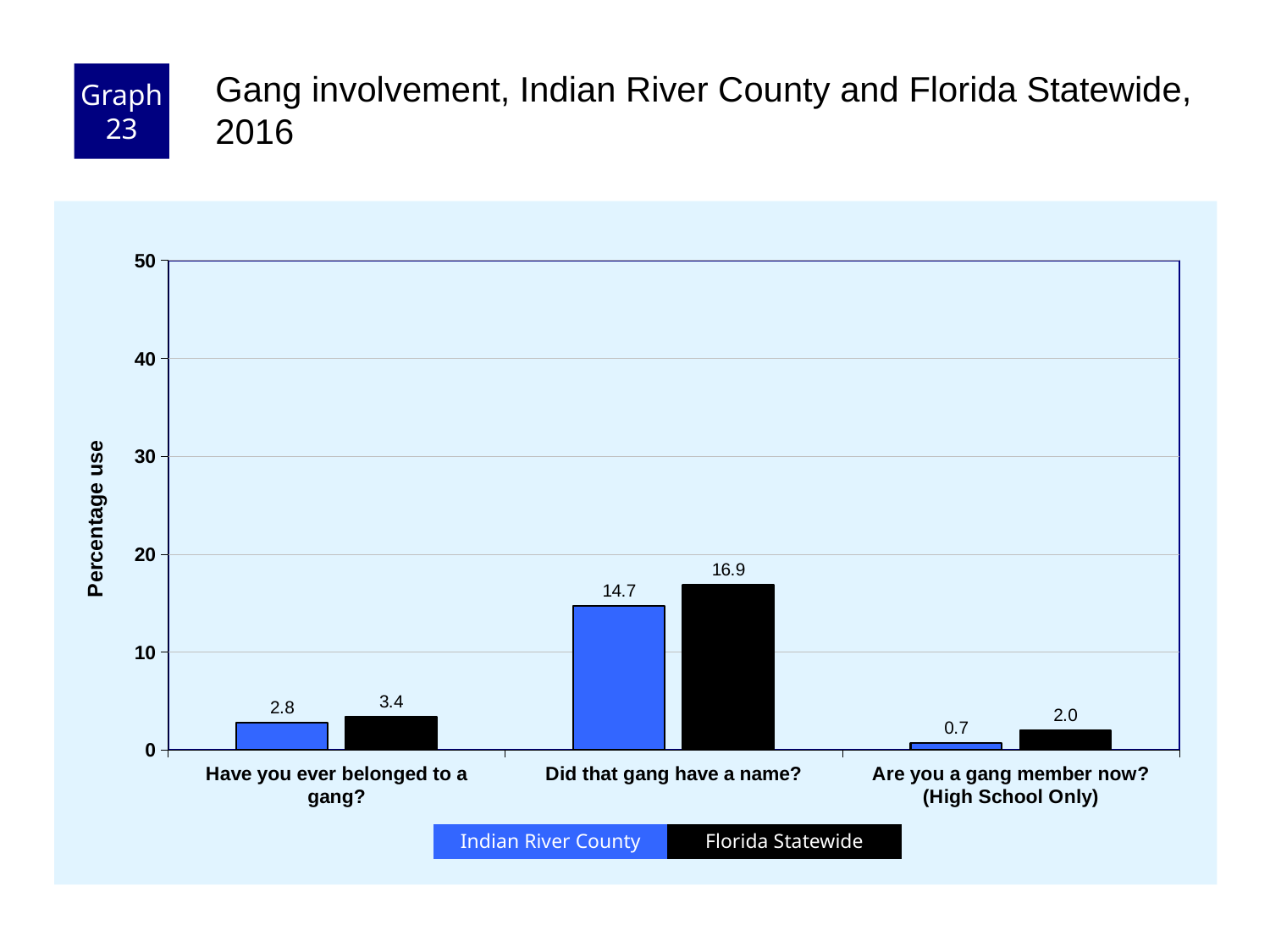
What is the Indian River County value for "Are you a gang member now? (High School Only)"? 0.7 What is the label of the y axis? Percentage use What is the Florida Statewide value for "Have you ever belonged to a gang?"? 3.4 Which question has the lowest Indian River County value? Are you a gang member now? (High School Only) Is the Florida Statewide value for "Did that gang have a name?" greater or less than 20? less Which question has the highest Florida Statewide value? Did that gang have a name? How many questions (categories) are shown on the x axis? 3 What kind of chart is shown on the slide? bar chart What is the Indian River County value for "Did that gang have a name?"? 14.7 What is the difference between the Florida Statewide and Indian River County values for "Did that gang have a name?"? 2.2 For "Are you a gang member now? (High School Only)", which is larger: Indian River County or Florida Statewide? Florida Statewide How many series does the legend list? 2